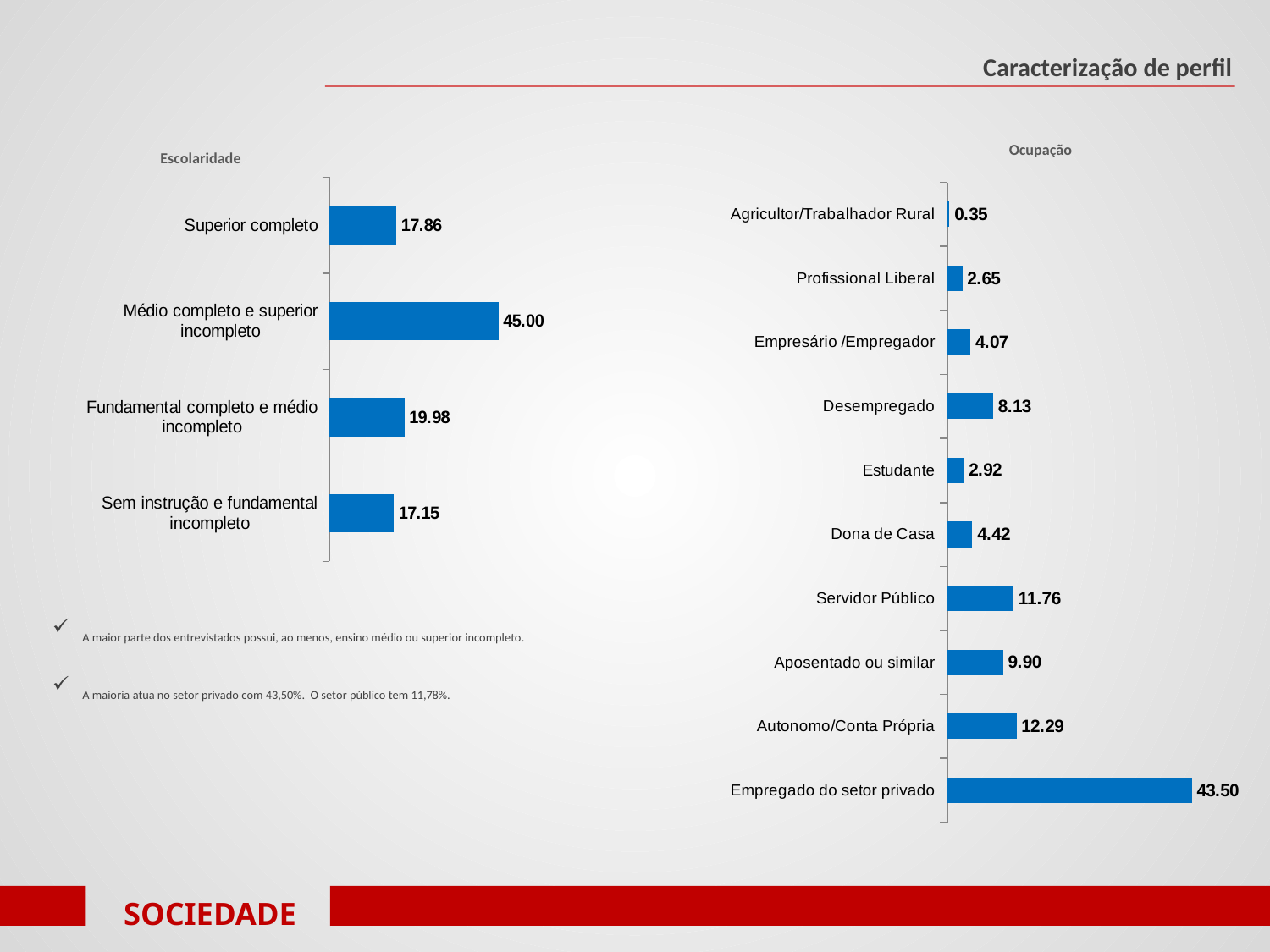
In the Ocupação chart, what is the difference between Empregado do setor privado and Autonomo/Conta Própria? 31.21 In the Escolaridade chart, what kind of chart is it? Bar chart What is the title of the slide? Caracterização de perfil In the Ocupação chart, which category has the highest value? Empregado do setor privado In the Escolaridade chart, what is the difference between Fundamental completo e médio incompleto and Superior completo? 2.12 In the Ocupação chart, how many categories are shown? 10 In the Escolaridade chart, what is the value for Médio completo e superior incompleto? 45.00 In the Ocupação chart, what is the value for Servidor Público? 11.76 In the Ocupação chart, which is larger: Aposentado ou similar or Desempregado? Aposentado ou similar In the Escolaridade chart, which category has the lowest value? Sem instrução e fundamental incompleto In the Ocupação chart, which category has the lowest value? Agricultor/Trabalhador Rural In the Escolaridade chart, how many categories are shown? 4